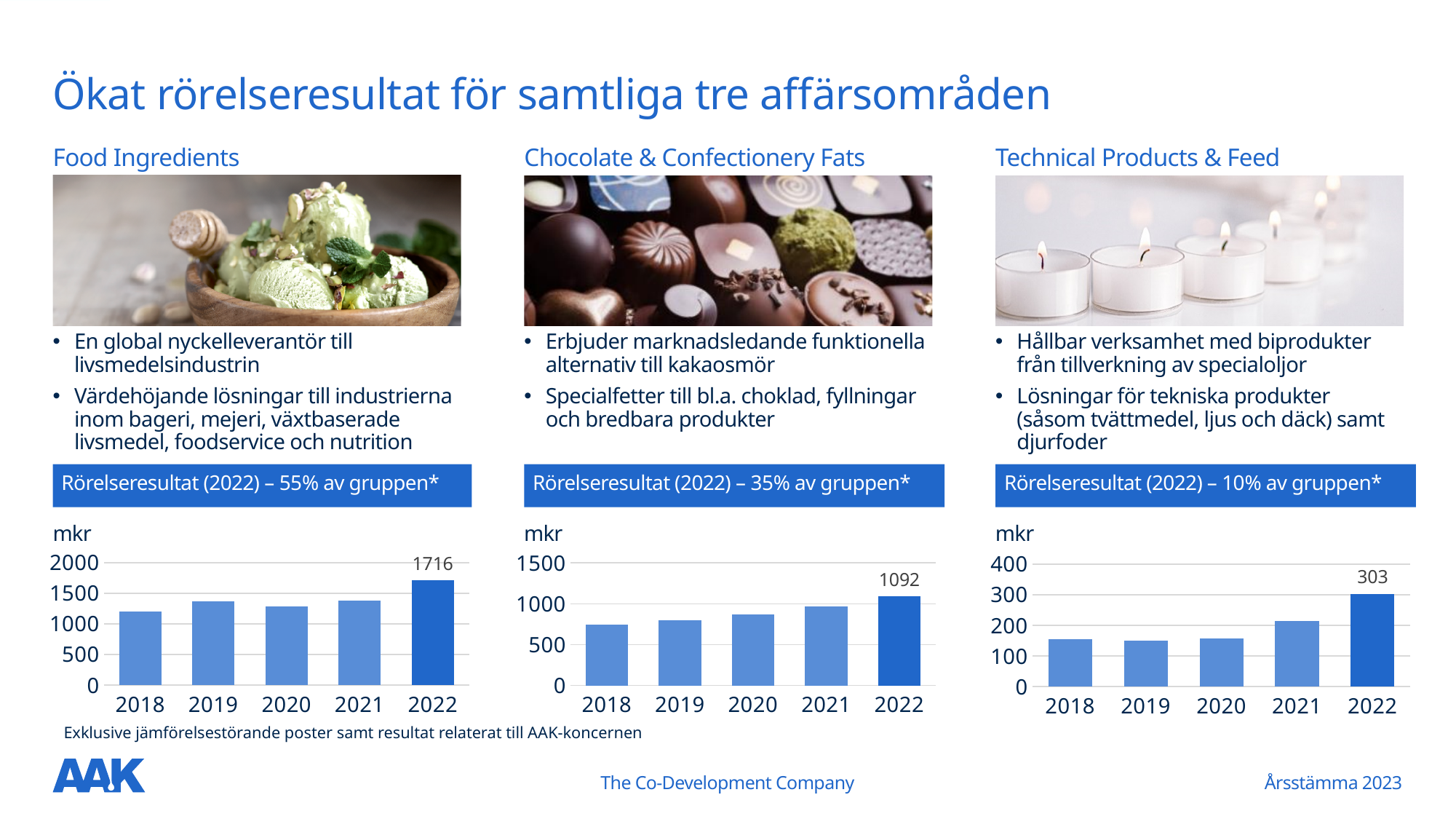
In the Chocolate & Confectionery Fats chart, what is the value for 2022? 1092 In the Technical Products & Feed chart, which year has the highest value? 2022 In the Technical Products & Feed chart, which is larger, the value for 2021 or the value for 2018? 2021 In the Food Ingredients chart, which year has the highest value? 2022 In the Chocolate & Confectionery Fats chart, do the values rise or fall from 2018 to 2022? rise In the Chocolate & Confectionery Fats chart, which year has the lowest value? 2018 In the Food Ingredients chart, what is the value for 2022? 1716 In the Technical Products & Feed chart, what is the value for 2022? 303 In the Food Ingredients chart, which year has the lowest value? 2018 How many years are shown on the x axis of the Chocolate & Confectionery Fats chart? 5 In the Food Ingredients chart, is the value for 2018 greater or less than 1500? less